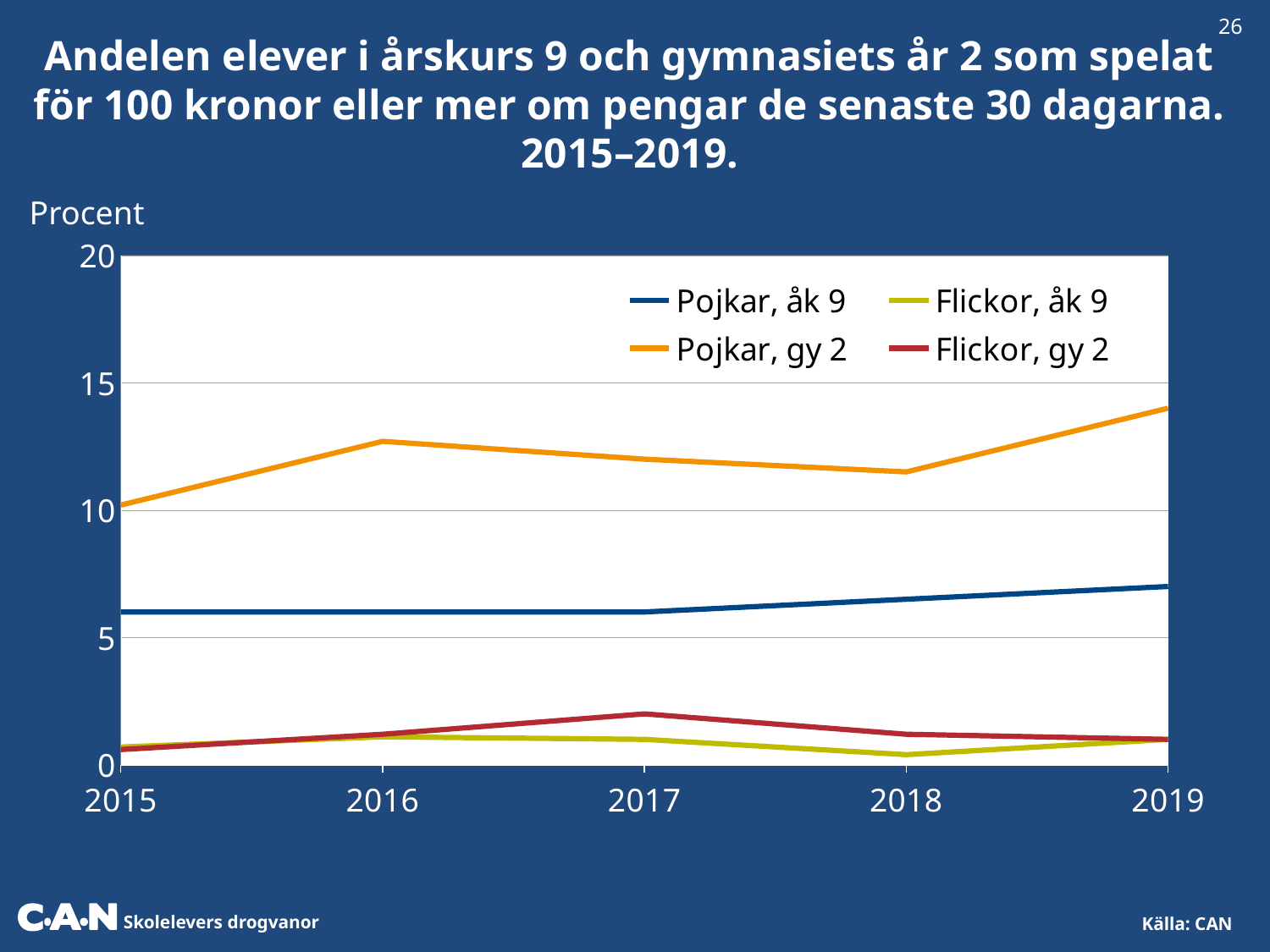
Which series has the highest value in 2019? Pojkar, gy 2 Is the value for Pojkar, gy 2 in 2019 greater or less than 10? greater How many years are shown on the x axis? 5 Is the value for Pojkar, gy 2 in 2015 greater or less than 15? less What kind of chart is shown on the slide? line chart Which is larger in 2017, the value for Pojkar, gy 2 or the value for Pojkar, åk 9? Pojkar, gy 2 What is the label on the y axis of the chart? Procent How many series does the legend list? 4 Is the value for Pojkar, åk 9 in 2015 greater or less than 5? greater In which year is the value for Pojkar, gy 2 highest? 2019 In which year is the value for Pojkar, gy 2 lowest? 2015